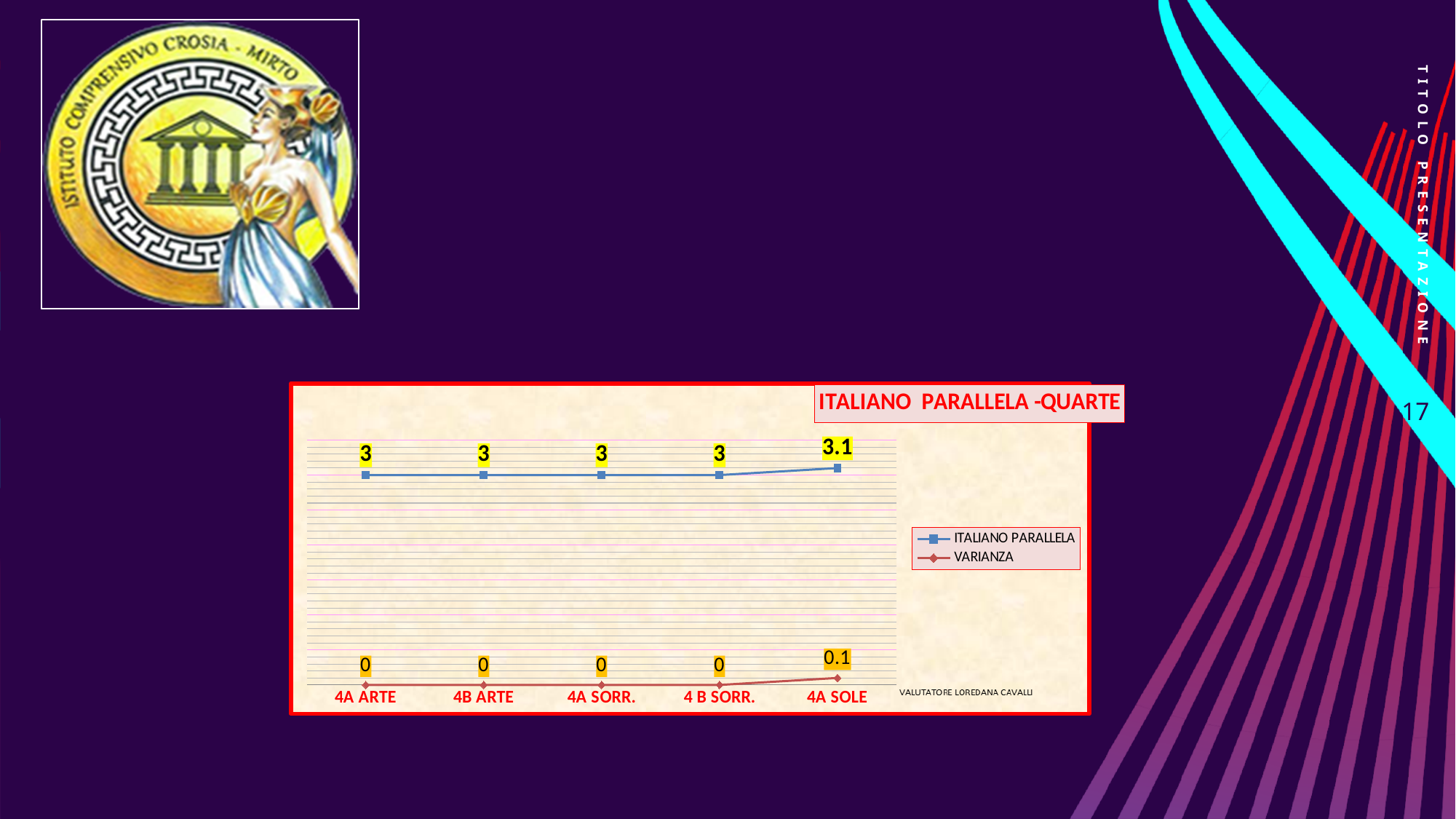
What is the ITALIANO PARALLELA value for 4A SOLE? 3.1 What kind of chart is shown? line chart What is the difference between the ITALIANO PARALLELA values for 4A SOLE and 4 B SORR.? 0.1 What is the ITALIANO PARALLELA value for 4B ARTE? 3 What is the title of the chart? ITALIANO PARALLELA -QUARTE How many series does the legend list? 2 Which category has the highest ITALIANO PARALLELA value? 4A SOLE Which is larger, the ITALIANO PARALLELA value for 4A SOLE or for 4A ARTE? 4A SOLE Which category has the highest VARIANZA value? 4A SOLE What is the VARIANZA value for 4A SORR.? 0 How many categories are shown on the x axis? 5 What is the VARIANZA value for 4A SOLE? 0.1